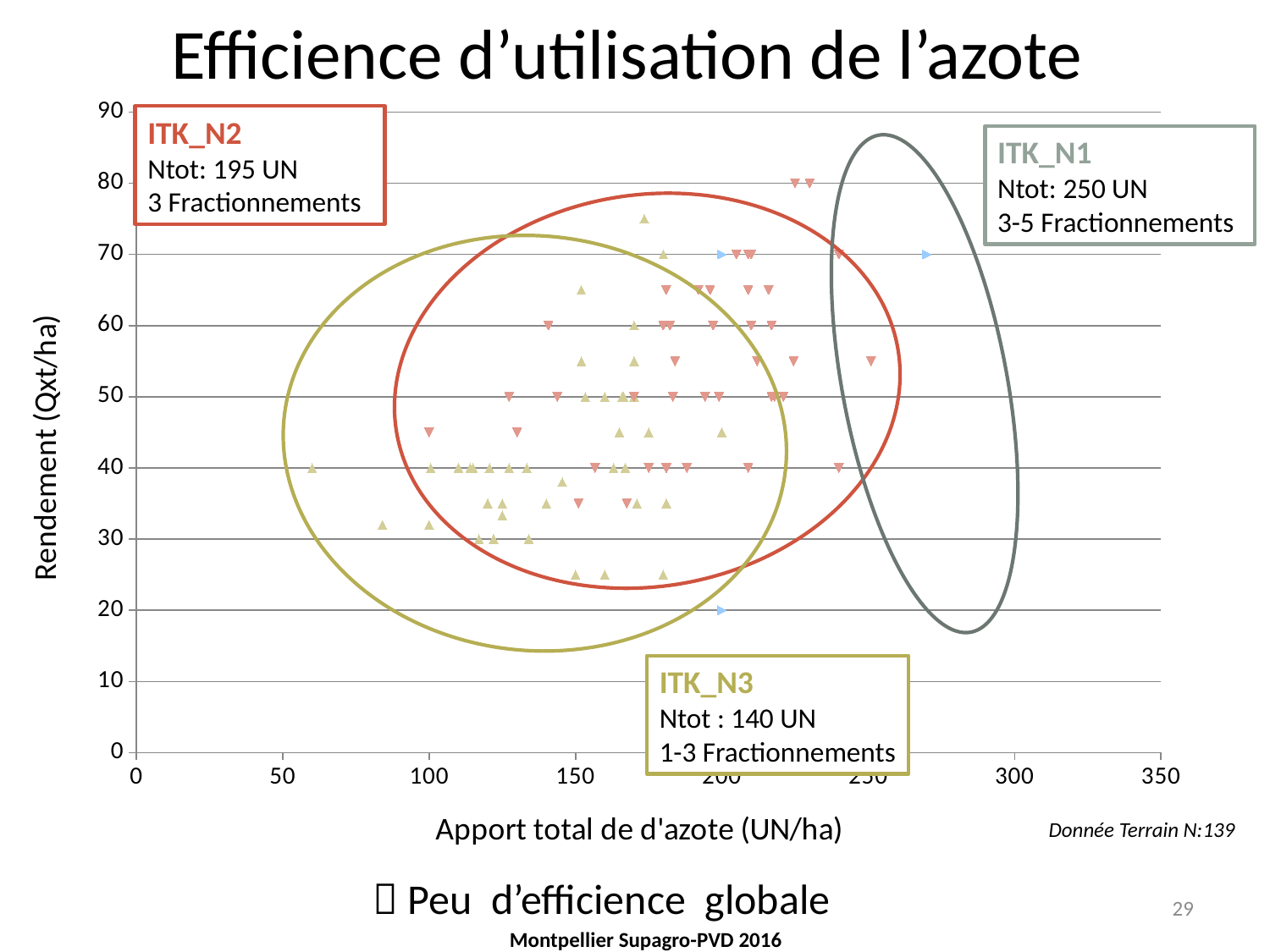
How many field data points (N) does the chart note? 139 How many ITK groups are annotated on the chart? 3 What is the difference in Ntot between ITK_N1 and ITK_N2? 55 UN How many fractionnements are indicated for ITK_N2? 3 Fractionnements Which ITK group has the highest Ntot value? ITK_N1 What is the Ntot value given for ITK_N1? 250 UN What is the Ntot value given for ITK_N2? 195 UN What is the label of the x axis? Apport total de d'azote (UN/ha) Which ITK group has the lowest Ntot value? ITK_N3 What kind of chart is shown on the slide? Scatter chart What is the title of the chart? Efficience d'utilisation de l'azote What is the Ntot value given for ITK_N3? 140 UN